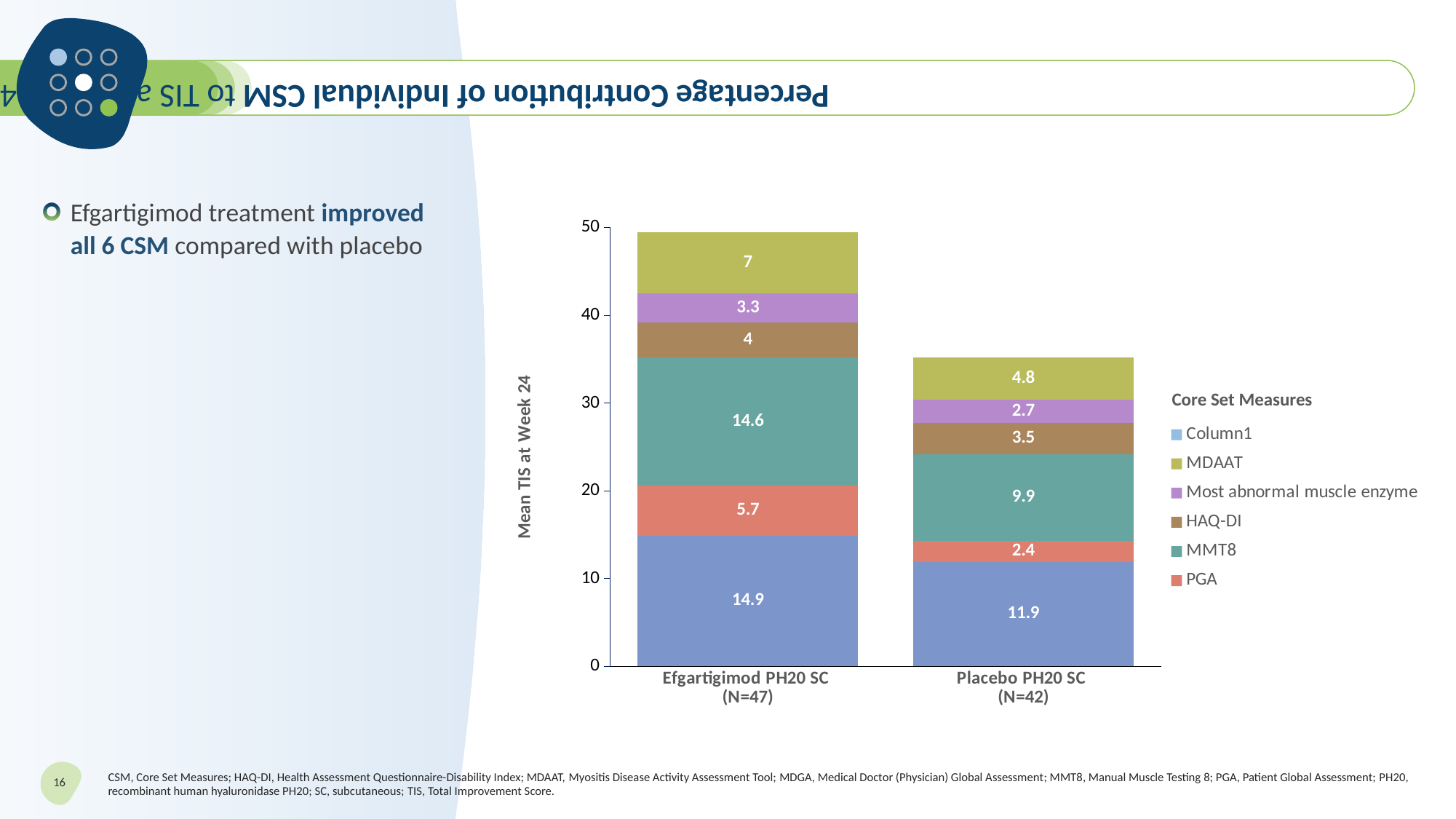
What is the HAQ-DI value for Placebo PH20 SC (N=42)? 3.5 What is the total of the stacked bar for Efgartigimod PH20 SC (N=47)? 49.5 What is the PGA value for Placebo PH20 SC (N=42)? 2.4 What is the label of the y axis? Mean TIS at Week 24 What is the total of the stacked bar for Placebo PH20 SC (N=42)? 35.2 What type of chart is shown on the slide? Stacked bar chart What is the MDAAT value for Efgartigimod PH20 SC (N=47)? 7 How many series does the legend list? 6 Which bar has the larger Most abnormal muscle enzyme value, Efgartigimod PH20 SC or Placebo PH20 SC? Efgartigimod PH20 SC How many bars (categories) are plotted on the x axis? 2 What is the difference between the MMT8 values for Efgartigimod PH20 SC and Placebo PH20 SC? 4.7 What is the MMT8 value for Efgartigimod PH20 SC (N=47)? 14.6